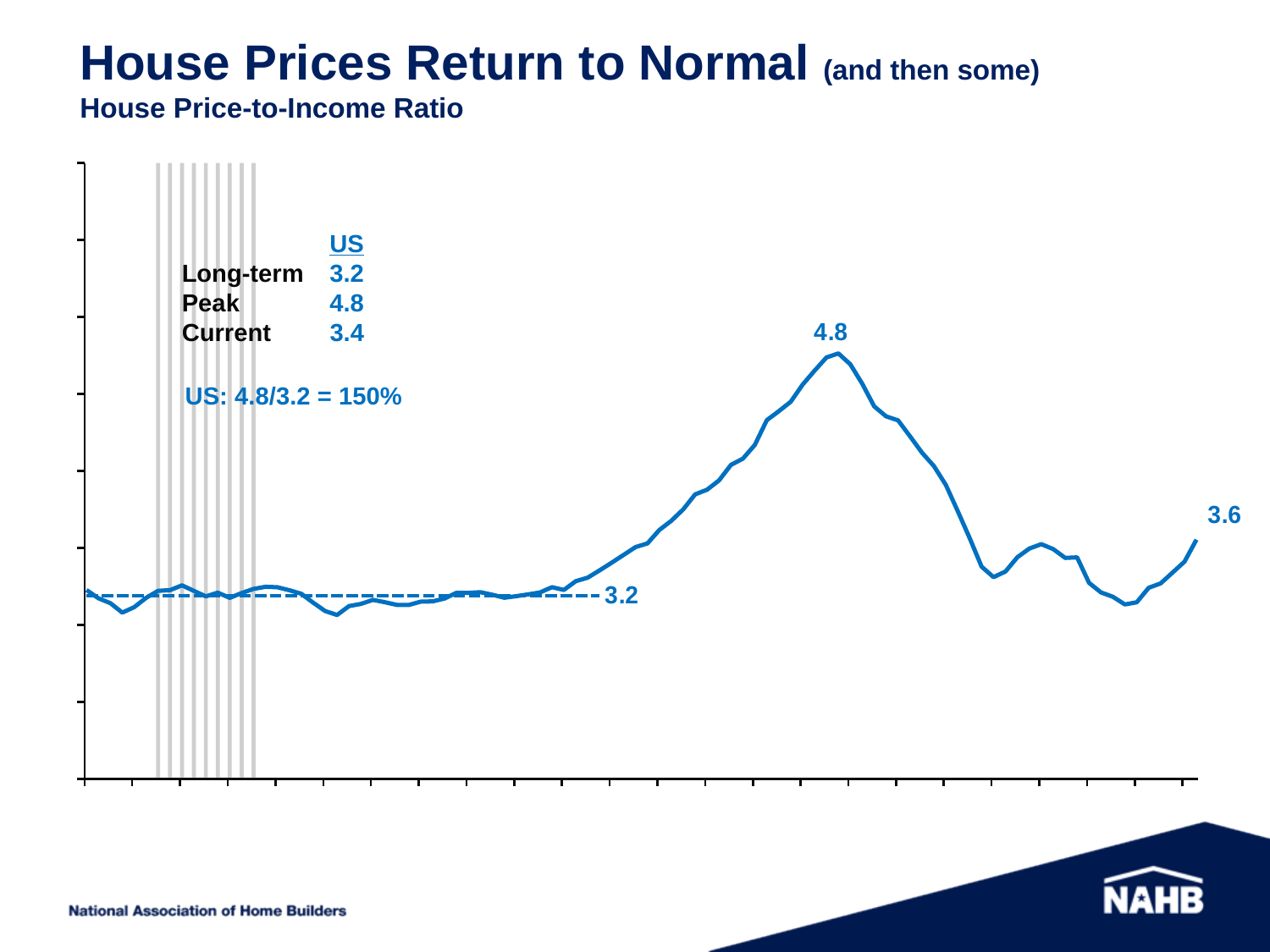
What kind of chart is shown on the slide? line chart According to the text box, what is the US long-term house price-to-income ratio? 3.2 What is the subtitle of the chart? House Price-to-Income Ratio Does the line rise or fall from the labelled peak of 4.8 toward the right side of the chart? fall What value is labelled at the right-hand end of the line? 3.6 What value is labelled on the dashed horizontal line? 3.2 Which is larger: the value at the right-hand end of the line or the dashed long-term line? the right-hand end of the line (3.6) What is the difference between the peak value (4.8) and the long-term value (3.2)? 1.6 What percentage does the slide give for US 4.8/3.2? 150% What is the difference between the final labelled value (3.6) and the dashed-line value (3.2)? 0.4 What is the peak value labelled on the line? 4.8 According to the text box, what is the US current house price-to-income ratio? 3.4